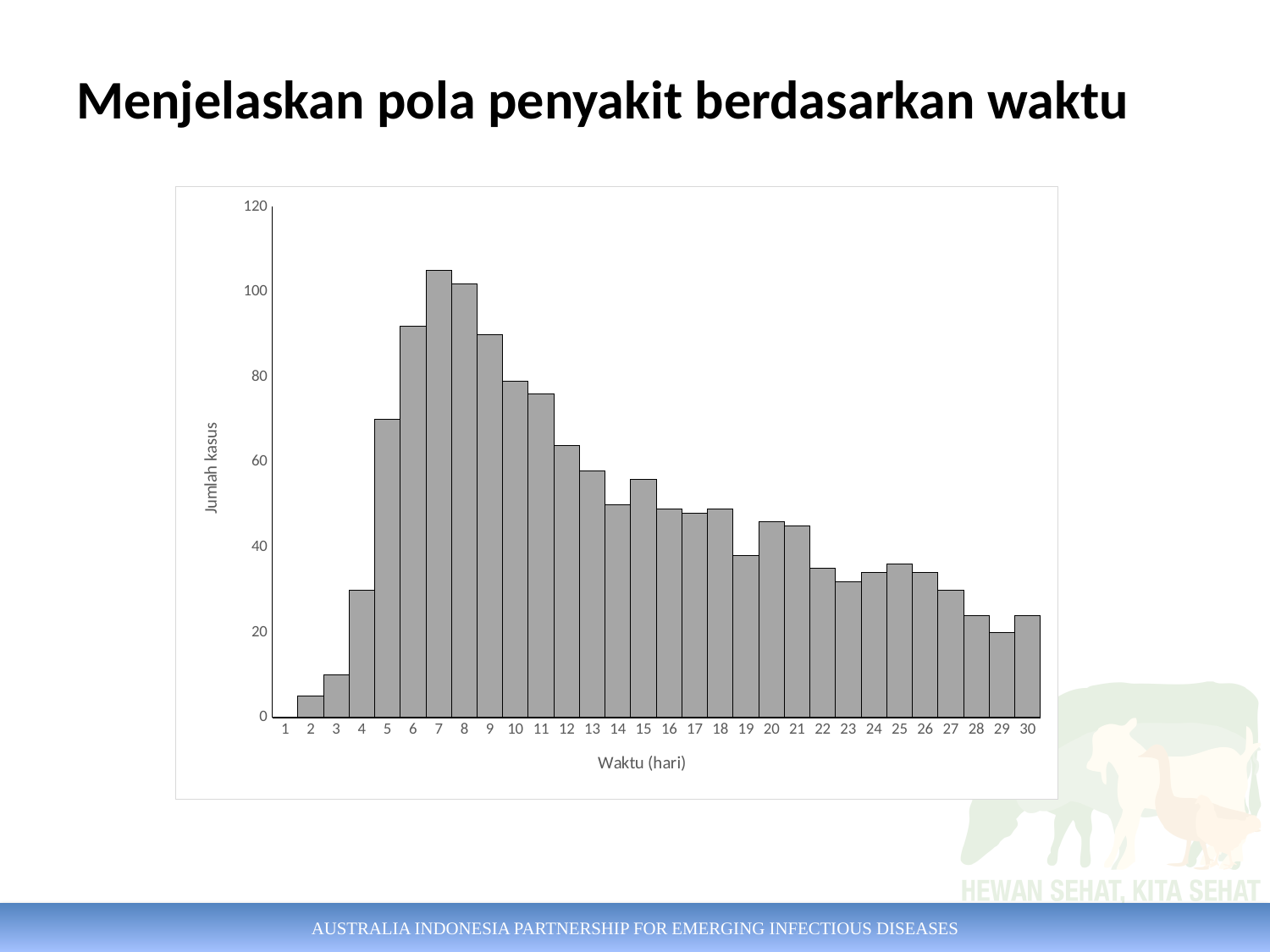
Which day has more cases, day 6 or day 13? 6 Is the value for day 12 greater or less than 60? greater On which day is the number of cases highest? 7 Is the value for day 7 greater or less than 100? greater Do the values generally rise or fall from day 8 to day 30? fall Is the value for day 4 greater or less than 40? less On which day is the number of cases lowest? 1 What is the label of the vertical axis? Jumlah kasus How many days (categories) are plotted along the x axis? 30 Which day has more cases, day 19 or day 22? 19 What kind of chart is shown on the slide? bar chart